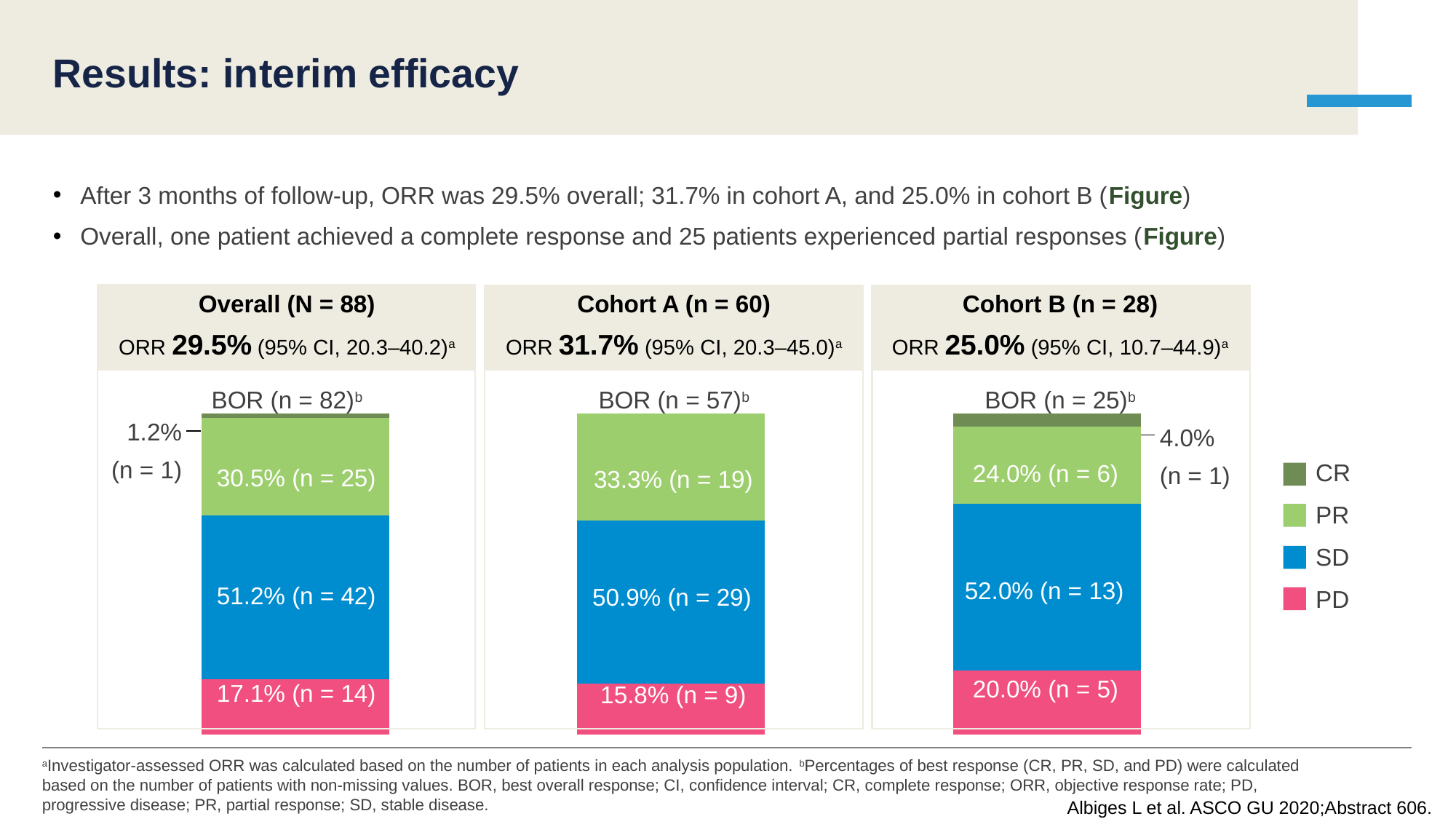
Is the PD percentage larger in the Overall (N = 88) chart or in the Cohort A (n = 60) chart? Overall (N = 88) In the Overall (N = 88) chart, what percentage is shown for CR? 1.2% In the Overall (N = 88) chart, which response category has the smallest share of the bar? CR What kind of chart is used to show best overall response on this slide? Stacked bar chart In the Cohort B (n = 28) chart, what is the value shown for PD? 20.0% (n = 5) In the Overall (N = 88) chart, what is the value shown for PR? 30.5% (n = 25) In the Overall (N = 88) chart, what is the difference in percentage points between SD and PR? 20.7 How many stacked bars are shown on the slide in total? 3 In the Cohort A (n = 60) chart, what is the value shown for SD? 50.9% (n = 29) In the Cohort B (n = 28) chart, which response category has the largest share of the bar? SD In the Cohort B (n = 28) chart, what percentage is shown for CR? 4.0% How many response categories does the legend list? 4